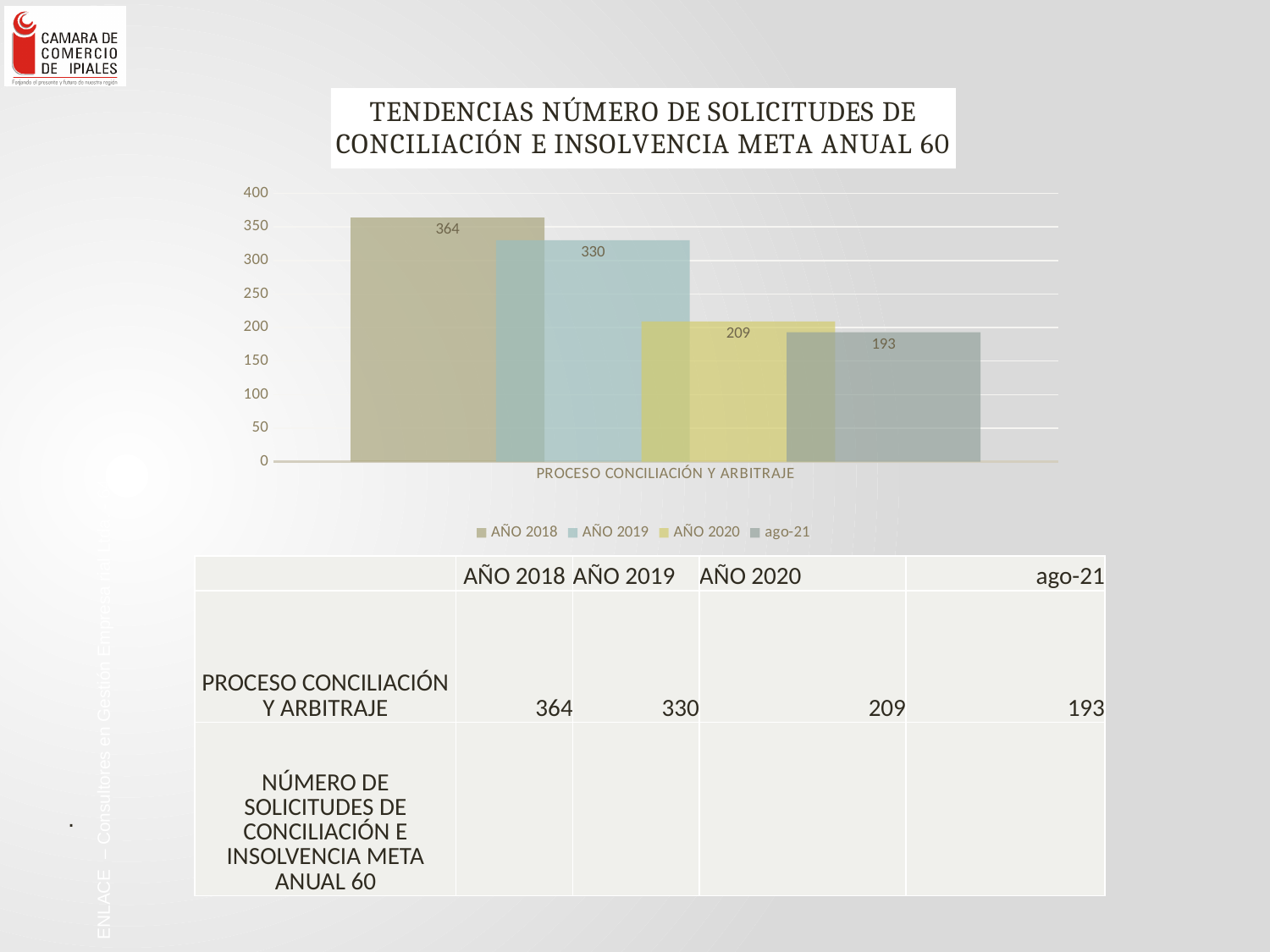
What is the value for AÑO 2018 in the chart? 364 What kind of chart is shown on the slide? bar chart What is the value for AÑO 2020 in the chart? 209 Is the value for AÑO 2019 greater or less than 300? greater Which series has the highest value in the chart? AÑO 2018 What is the value for ago-21 in the chart? 193 What is the difference between the values for AÑO 2018 and AÑO 2019? 34 Which series has the lowest value in the chart? ago-21 What is the difference between the values for AÑO 2020 and ago-21? 16 Which is larger, the value for AÑO 2019 or the value for AÑO 2020? AÑO 2019 Do the values rise or fall from AÑO 2018 to ago-21? fall How many series does the legend list? 4